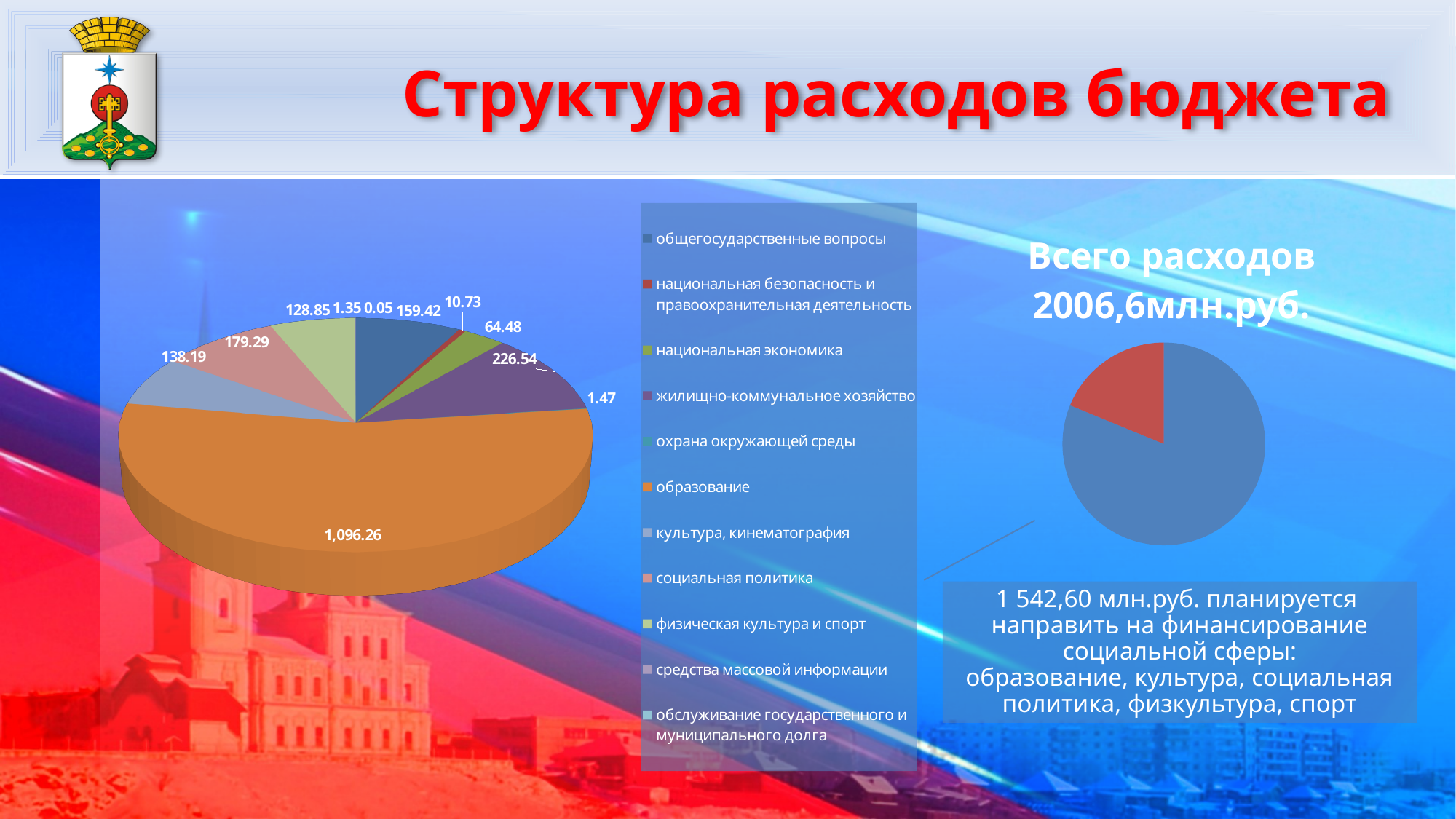
How many slices does the small pie chart on the right of the slide have? 2 In the large pie chart on the left, what is the difference between the values for социальная политика and культура, кинематография? 41.10 In the large pie chart on the left, which category has the largest value? образование How many categories does the legend of the large pie chart on the left list? 11 In the large pie chart on the left, what is the value for социальная политика? 179.29 In the large pie chart on the left, what is the value for образование? 1,096.26 In the large pie chart on the left, which category has the smallest value? обслуживание государственного и муниципального долга In the large pie chart on the left, what is the value for физическая культура и спорт? 128.85 In the large pie chart on the left, what is the value for жилищно-коммунальное хозяйство? 226.54 What kind of chart is the large chart on the left of the slide? pie chart In the large pie chart on the left, what is the value for общегосударственные вопросы? 159.42 In the large pie chart on the left, which is larger: национальная экономика or национальная безопасность и правоохранительная деятельность? национальная экономика